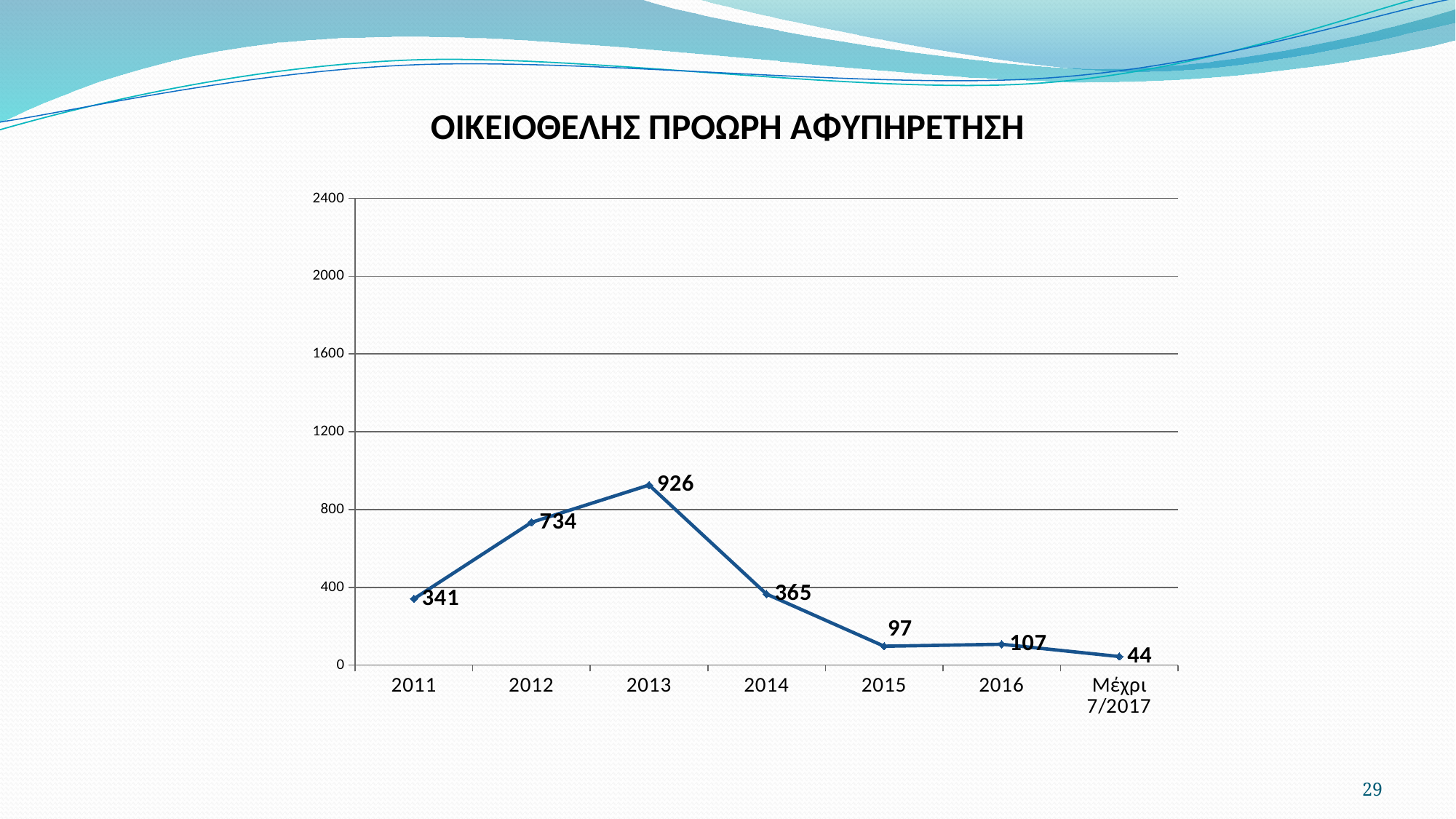
Which category has the lowest value? Μέχρι 7/2017 Which year has the highest value? 2013 What is the difference between the values for 2012 and 2011? 393 How many data points are plotted on the chart? 7 Which is larger, the value for 2015 or the value for 2016? 2016 What is the value for 2013? 926 What is the value for Μέχρι 7/2017? 44 What is the value for 2011? 341 What kind of chart is shown on the slide? Line chart What is the difference between the values for 2013 and 2014? 561 What is the title of the chart? ΟΙΚΕΙΟΘΕΛΗΣ ΠΡΟΩΡΗ ΑΦΥΠΗΡΕΤΗΣΗ Is the value for 2012 greater or less than 400? greater